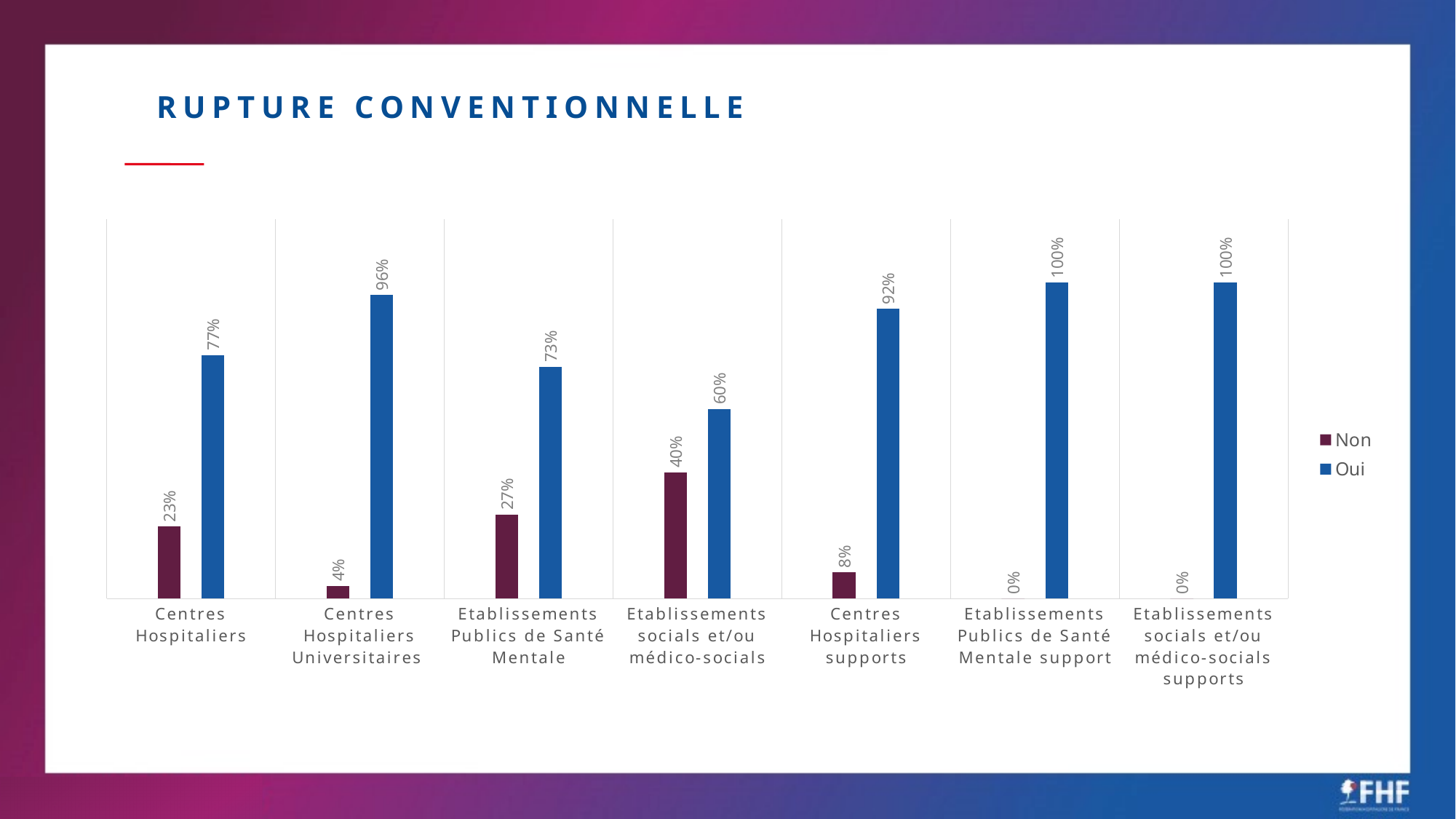
What is the 'Oui' value for Centres Hospitaliers Universitaires? 96% What is the 'Oui' value for Centres Hospitaliers supports? 92% What is the difference between the 'Oui' and 'Non' values for Etablissements Publics de Santé Mentale? 46% What is the 'Non' value for Etablissements socials et/ou médico-socials? 40% Which category has the highest 'Non' value? Etablissements socials et/ou médico-socials Which category has the lowest 'Oui' value? Etablissements socials et/ou médico-socials What is the title of the slide? RUPTURE CONVENTIONNELLE How many series does the legend list? 2 Which is larger: the 'Non' value for Centres Hospitaliers or the 'Non' value for Centres Hospitaliers supports? Centres Hospitaliers What kind of chart is shown on the slide? Bar chart How many categories are shown on the x axis? 7 What is the 'Non' value for Centres Hospitaliers? 23%